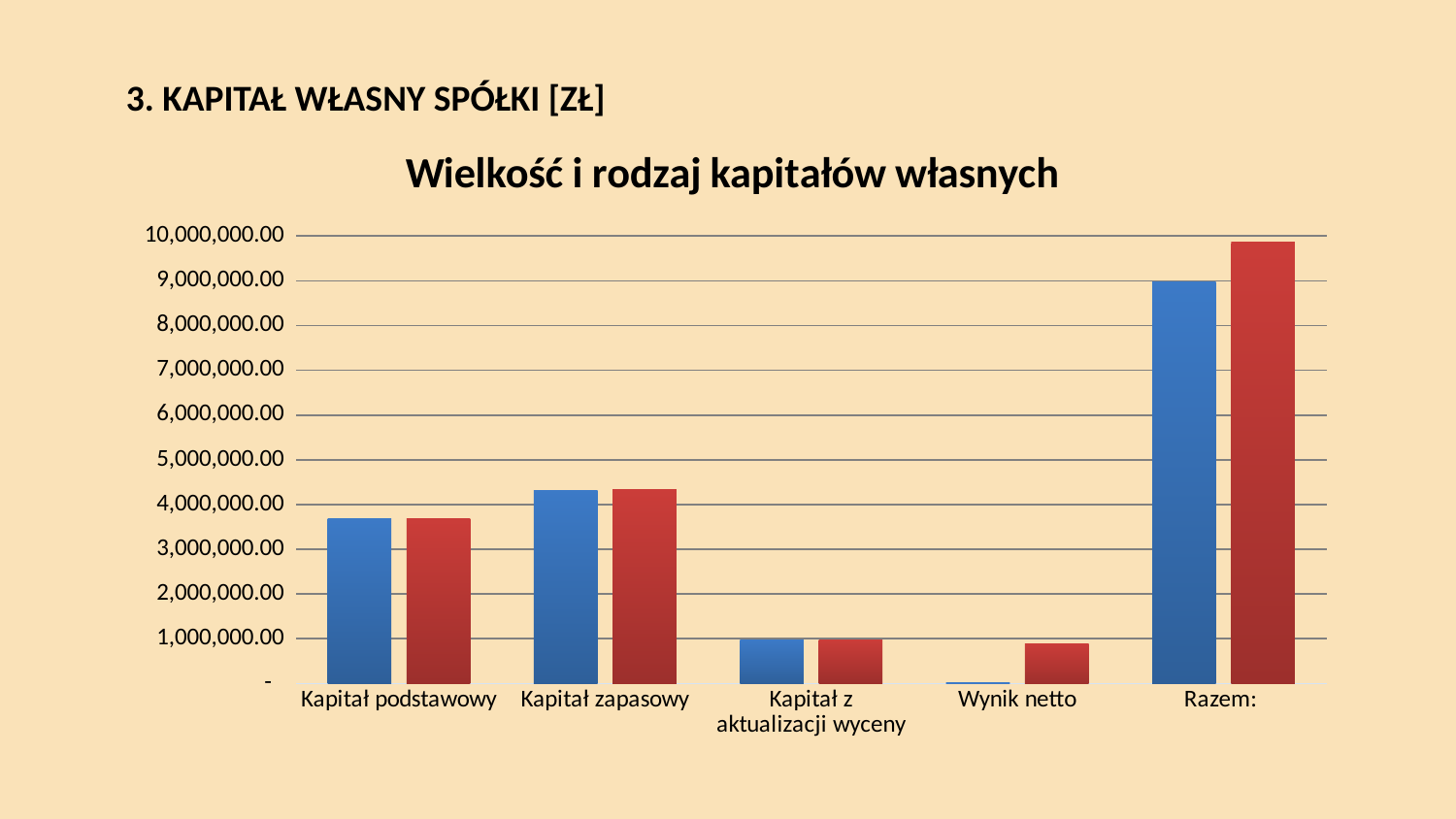
How many categories are shown on the x axis of the chart? 5 Is the red bar for Razem: greater or less than 9,000,000.00? greater What kind of chart is shown on the slide? bar chart What is the title of the chart? Wielkość i rodzaj kapitałów własnych For Wynik netto, which bar is larger, the blue one or the red one? red Is the blue bar for Kapitał zapasowy greater or less than 4,000,000.00? greater Is the red bar for Wynik netto greater or less than 1,000,000.00? less Which is larger, the blue bar for Kapitał zapasowy or the blue bar for Kapitał podstawowy? Kapitał zapasowy Which category has the highest bars in the chart? Razem: Which category has the lowest blue bar in the chart? Wynik netto